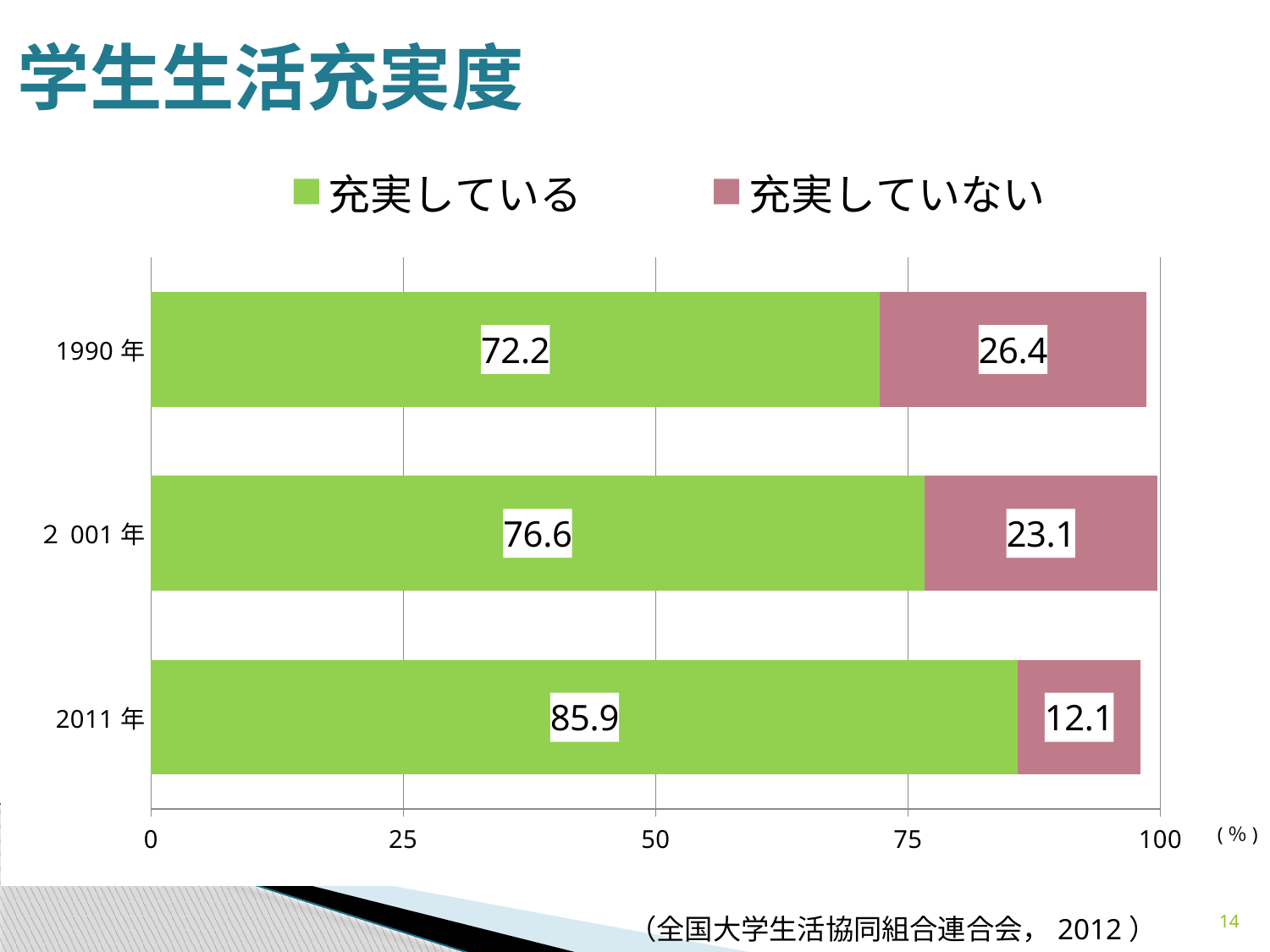
Which is larger, the 充実していない value for 1990年 or for 2001年? 1990年 Which year has the highest value for 充実している? 2011年 Which year has the lowest value for 充実していない? 2011年 What kind of chart is shown on the slide? Stacked bar chart What is the difference between the 充実している values for 2011年 and 1990年? 13.7 Is the value for 充実している in 2001年 greater or less than 75? greater What is the value for 充実していない in 2001年? 23.1 What is the total of the stacked bar for 1990年? 98.6 What is the value for 充実していない in 2011年? 12.1 How many years are shown on the chart? 3 What is the value for 充実している in 1990年? 72.2 How many series does the legend list? 2